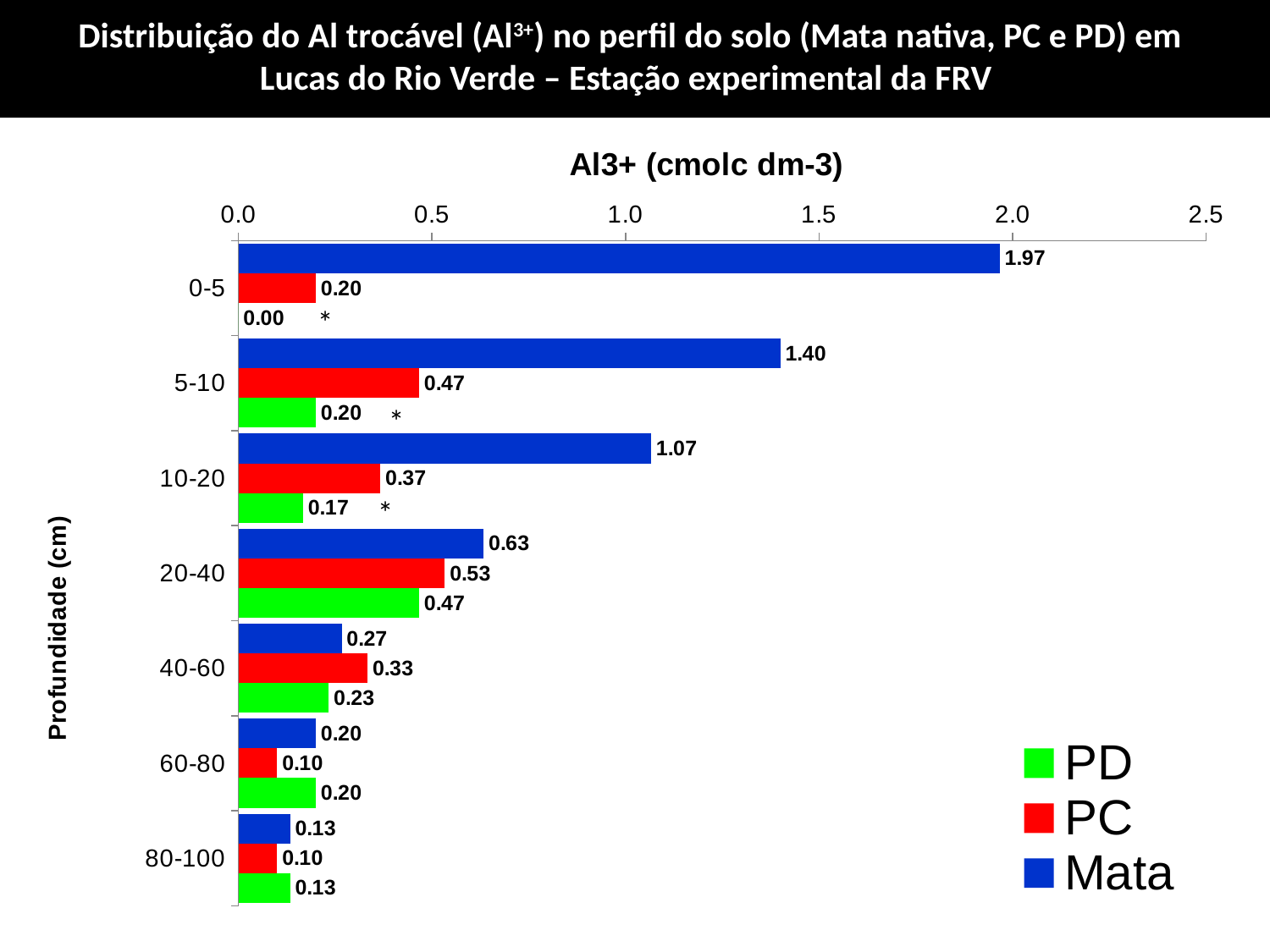
At which depth is the PD value lowest? 0-5 At the 40-60 cm depth, which is larger, the PC value or the Mata value? PC What kind of chart is shown on the slide? bar chart Which colour represents the Mata series in the legend? blue What is the PC value at the 5-10 cm depth? 0.47 How many depth categories are shown on the chart? 7 What is the difference between the Mata and PC values at the 10-20 cm depth? 0.70 What is the PD value at the 20-40 cm depth? 0.47 Is the Mata value at the 5-10 cm depth greater or less than 1.0? greater What is the Mata value at the 0-5 cm depth? 1.97 At which depth is the Mata value highest? 0-5 How many series does the legend list? 3